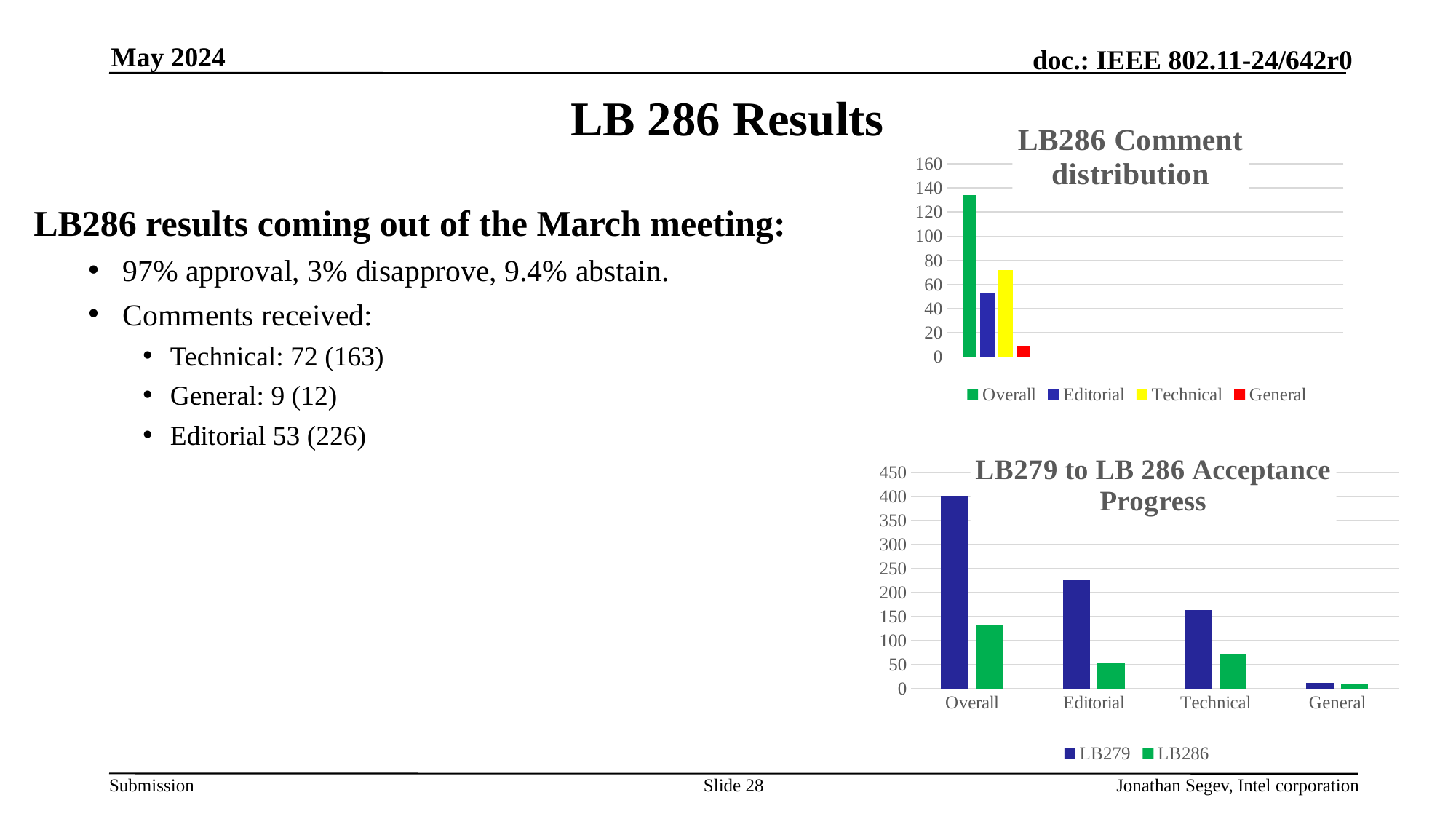
In the 'LB286 Comment distribution' chart, which series has the highest value? Overall In the 'LB279 to LB 286 Acceptance Progress' chart, which series is larger for Technical, LB279 or LB286? LB279 In the 'LB279 to LB 286 Acceptance Progress' chart, how many categories are shown on the x axis? 4 In the 'LB286 Comment distribution' chart, which is larger, Technical or Editorial? Technical In the 'LB279 to LB 286 Acceptance Progress' chart, is the LB279 value for Editorial greater or less than 200? greater In the 'LB286 Comment distribution' chart, is the value for Overall greater or less than 120? greater In the 'LB279 to LB 286 Acceptance Progress' chart, is the LB286 value for Overall greater or less than 150? less In the 'LB286 Comment distribution' chart, how many series does the legend list? 4 In the 'LB279 to LB 286 Acceptance Progress' chart, which category has the highest LB279 value? Overall In the 'LB286 Comment distribution' chart, which series has the lowest value? General In the 'LB279 to LB 286 Acceptance Progress' chart, how many series does the legend list? 2 In the 'LB286 Comment distribution' chart, what kind of chart is shown? bar chart